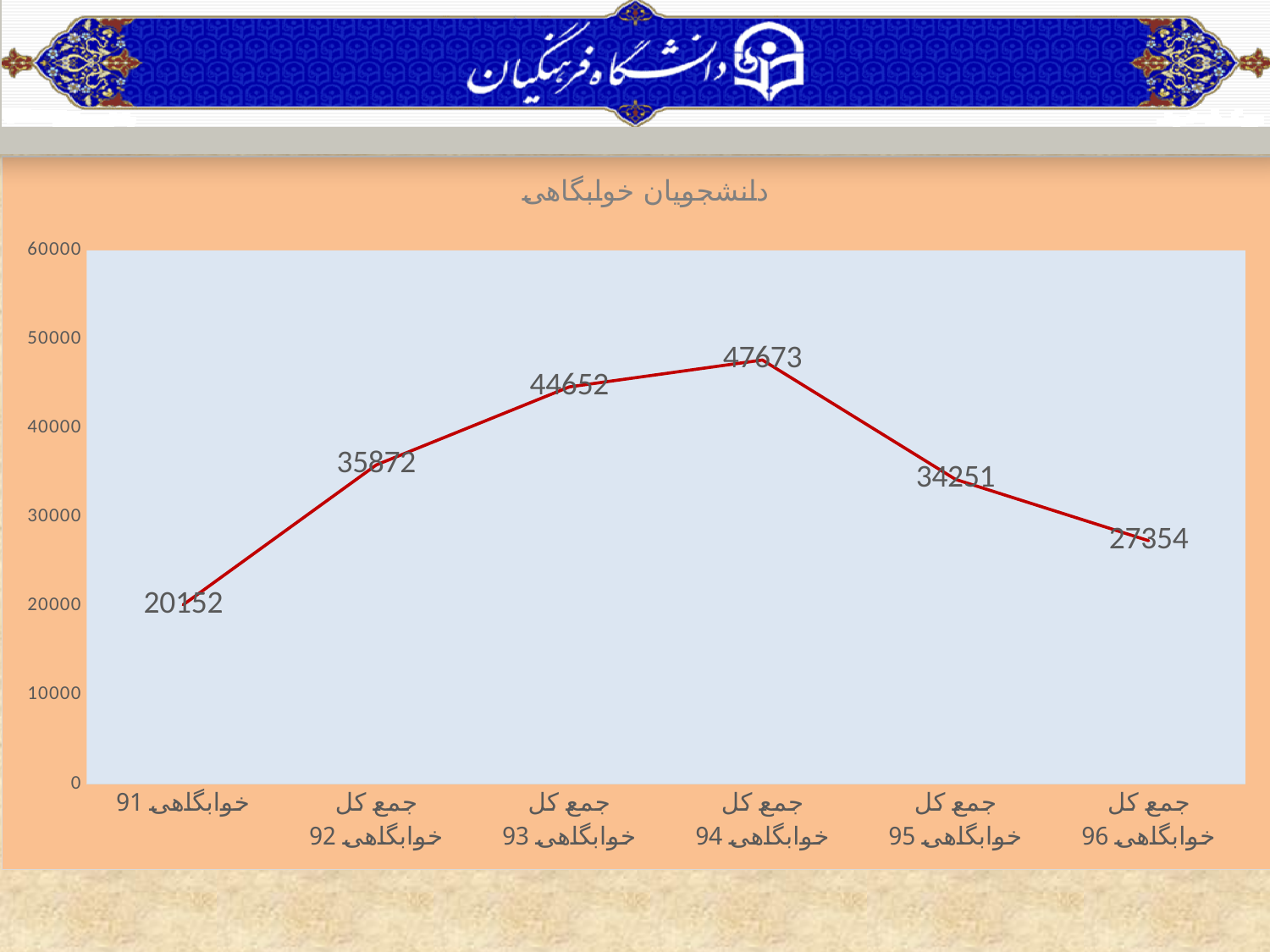
What is the value for جمع کل خوابگاهی 96? 27354 What is the value for جمع کل خوابگاهی 94? 47673 What is the difference between the values for جمع کل خوابگاهی 94 and جمع کل خوابگاهی 95? 13422 Is the value for جمع کل خوابگاهی 93 greater or less than 40000? greater How many data points are plotted on the line? 6 Which is larger, the value for جمع کل خوابگاهی 92 or جمع کل خوابگاهی 96? جمع کل خوابگاهی 92 What type of chart is shown on the slide? line chart What is the title of the chart? دانشجویان خوابگاهی What is the value for خوابگاهی 91? 20152 Does the line rise or fall from جمع کل خوابگاهی 94 to جمع کل خوابگاهی 96? fall Which category has the highest value? جمع کل خوابگاهی 94 Which category has the lowest value? خوابگاهی 91